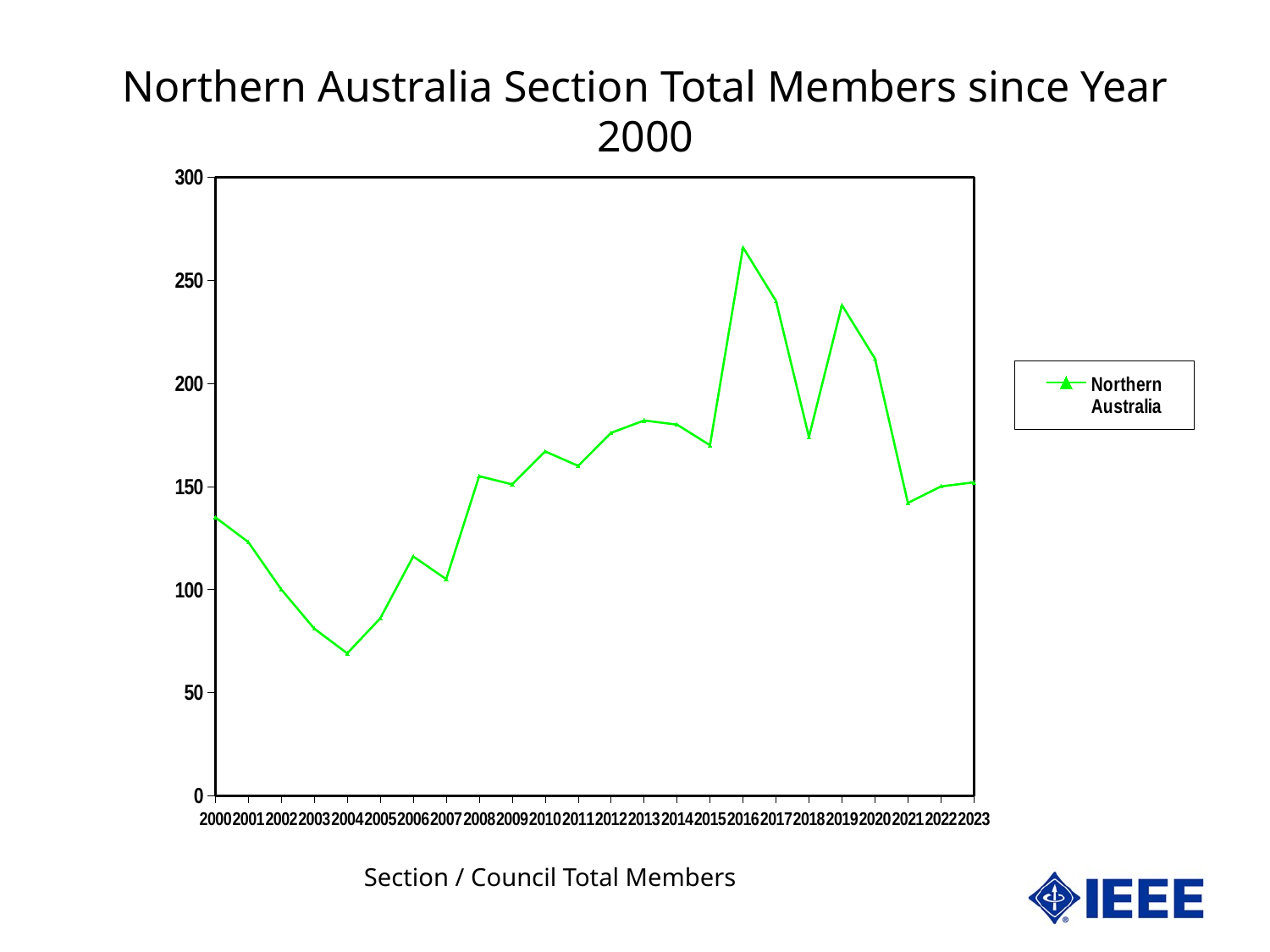
How many series does the legend list? 1 Is the value for 2013 greater or less than 150? greater Do the values rise or fall from 2000 to 2004? fall What is the title of the chart? Northern Australia Section Total Members since Year 2000 Is the value for 2019 greater or less than 250? less Is the value for 2016 greater or less than 250? greater In which year is the number of members highest? 2016 In which year is the number of members lowest? 2004 How many years are plotted along the x axis? 24 What kind of chart is shown on the slide? line chart Which year has more members, 2016 or 2019? 2016